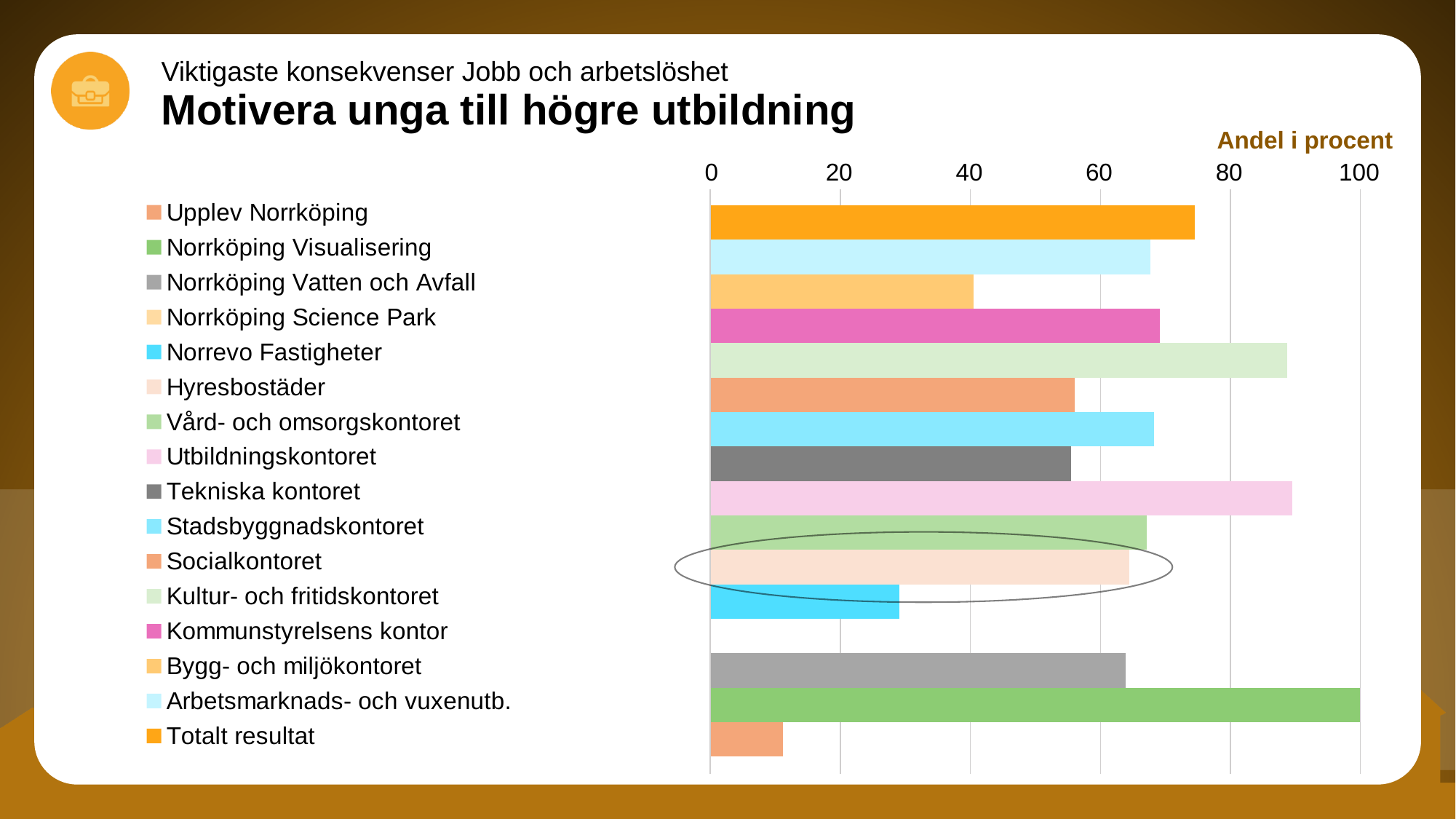
Is the value for Kultur- och fritidskontoret greater or less than 80? greater Which category has the highest value in the chart? Norrköping Visualisering Which is larger, the value for Kultur- och fritidskontoret or the value for Socialkontoret? Kultur- och fritidskontoret How many entries does the legend list? 16 Is the value for Totalt resultat greater or less than 60? greater What is the title of the slide containing the chart? Motivera unga till högre utbildning What kind of chart is shown on the slide? bar chart Is the value for Bygg- och miljökontoret greater or less than 60? less What is the label shown above the horizontal axis of the chart? Andel i procent Which is larger, the value for Utbildningskontoret or the value for Tekniska kontoret? Utbildningskontoret